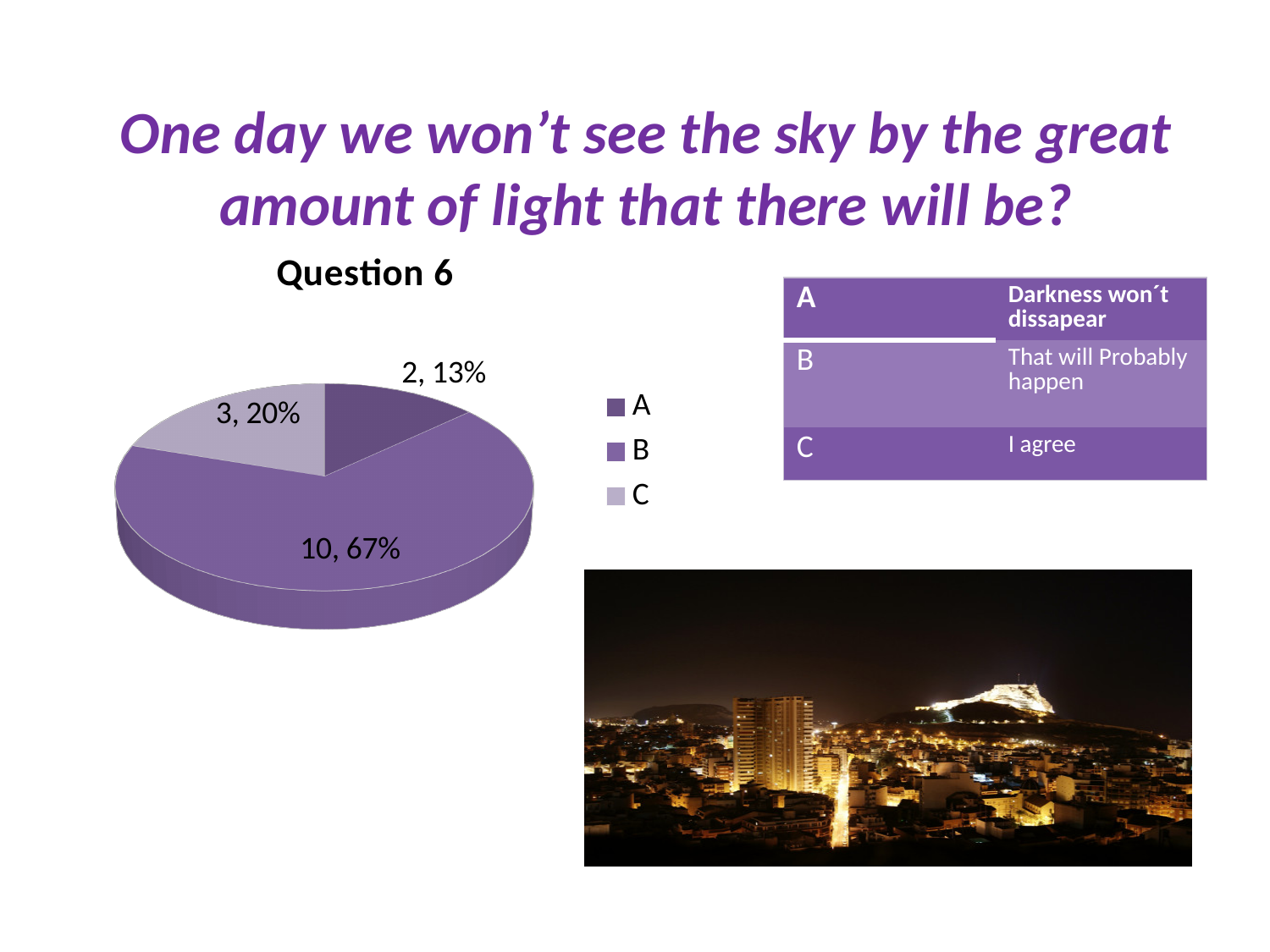
What share of the pie does category B represent? 67% Which category has the smallest slice? A What is the value for category C? 3 What is the value for category B? 10 Which category has the largest slice? B What share of the pie does category C represent? 20% How many slices does the pie chart have? 3 What is the title of the chart? Question 6 How many entries does the legend list? 3 What is the value for category A? 2 What type of chart is shown on the slide? pie chart What is the difference between the values for B and C? 7